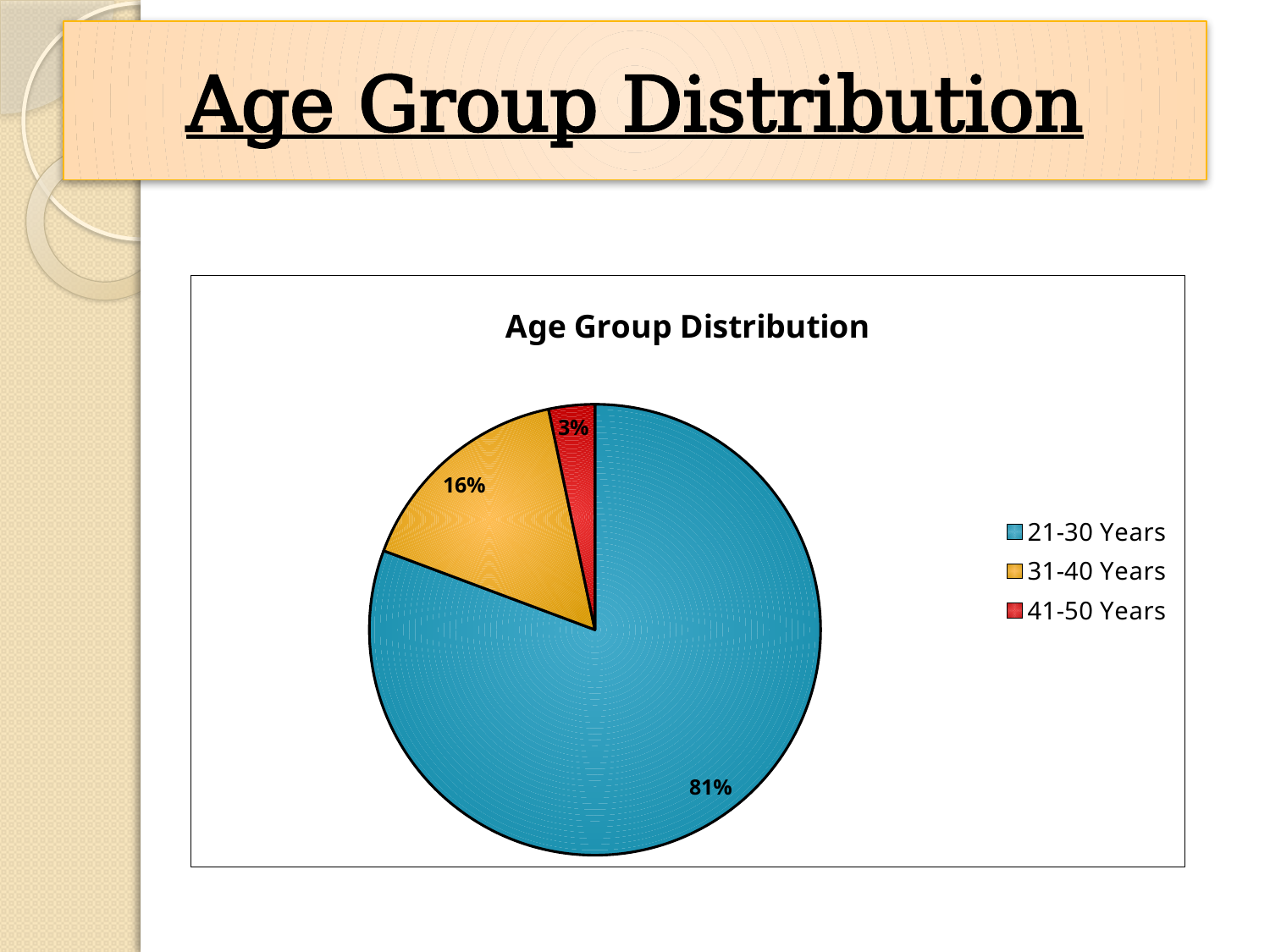
What is the difference in percentage points between the 21-30 Years and 31-40 Years slices? 65 What is the title of the chart? Age Group Distribution Which age group has the smallest share of the pie? 41-50 Years What colour is the 41-50 Years slice? Red Which slice is larger, 31-40 Years or 41-50 Years? 31-40 Years How many age groups are shown in the pie chart? 3 What share of the pie does the 41-50 Years slice represent? 3% What kind of chart is shown on the slide? Pie chart Which age group has the largest share of the pie? 21-30 Years What is the difference in percentage points between the 31-40 Years and 41-50 Years slices? 13 What share of the pie does the 21-30 Years slice represent? 81% What share of the pie does the 31-40 Years slice represent? 16%